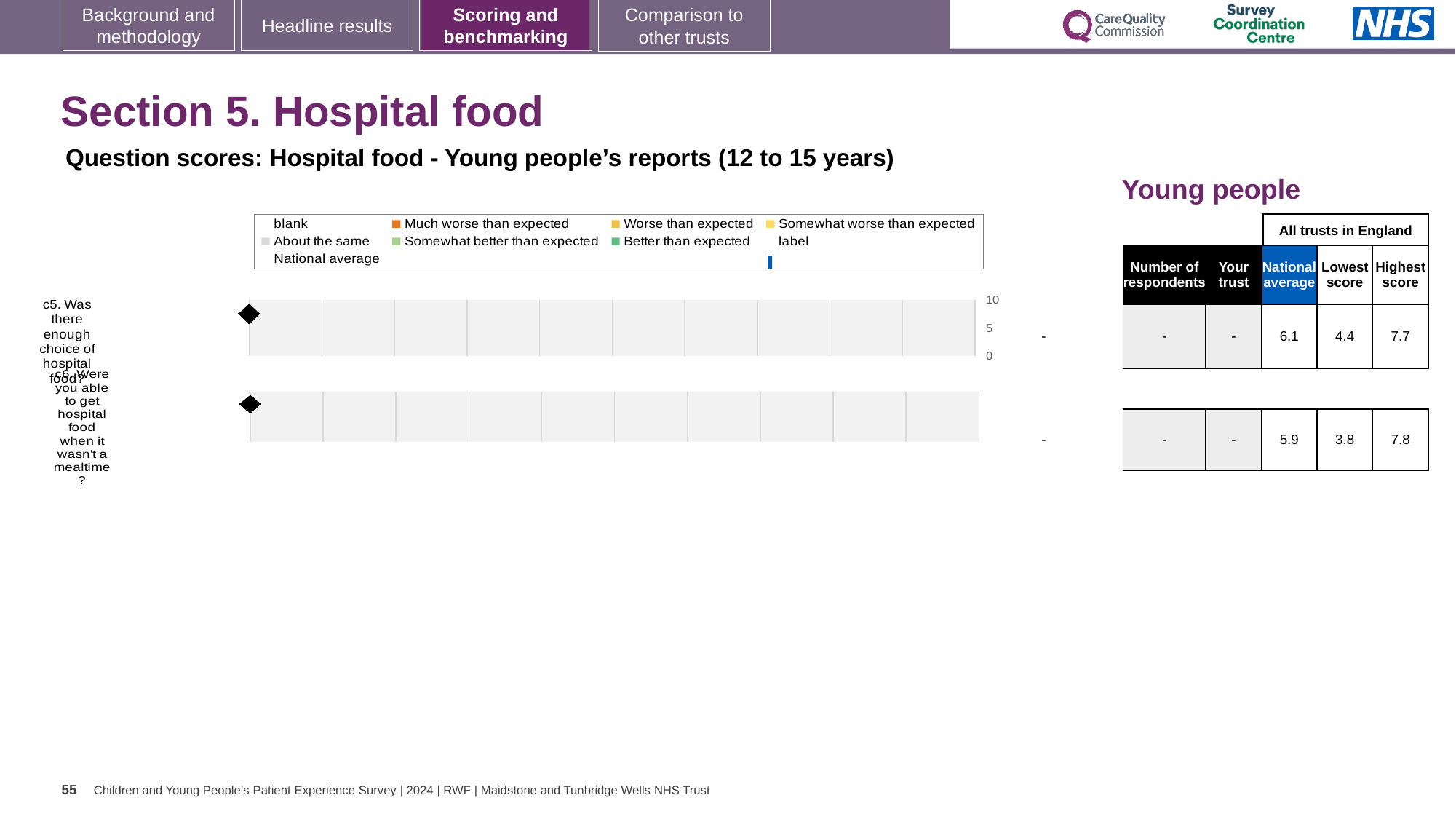
Which question has the higher national average in the table, c5 or c6? c5 What is the maximum value shown on the chart's axis? 10 In the table next to the chart, what is the national average score for c6 (Were you able to get hospital food when it wasn't a mealtime?)? 5.9 What is the difference between the highest and lowest scores for c6 in the table? 4.0 In the table next to the chart, what is the highest score across all trusts in England for c6? 7.8 How many question categories are plotted on the chart? 2 In the table next to the chart, what is the national average score for c5 (Was there enough choice of hospital food?)? 6.1 Which legend entry is shown with an orange marker? Much worse than expected In the table next to the chart, what is the lowest score across all trusts in England for c5? 4.4 What value is shown for 'Your trust' for c5 in the table? - What kind of chart is shown on the slide? bar chart